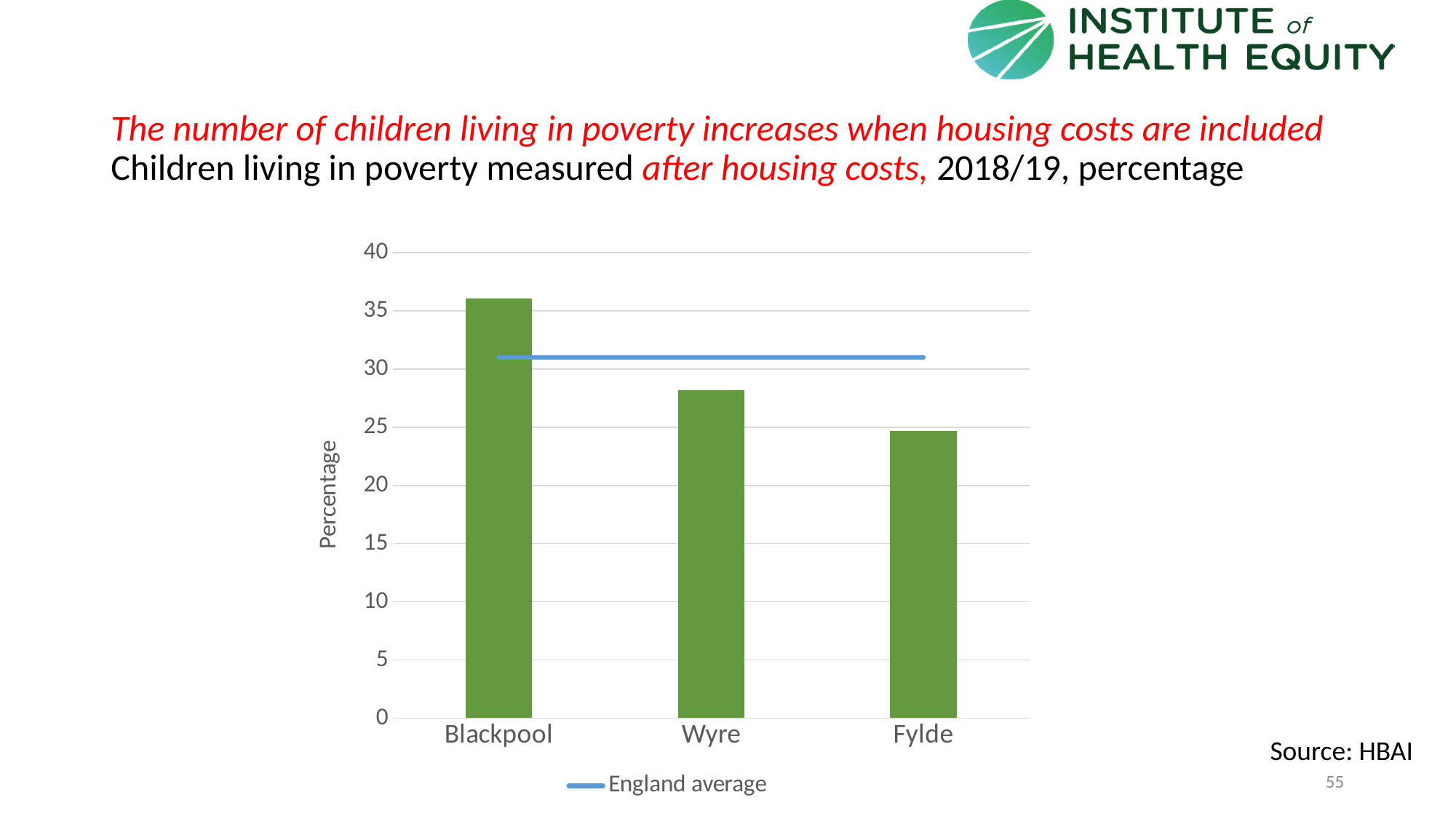
Which area's bar is above the England average line? Blackpool What kind of chart is shown on the slide? bar chart How many local areas are shown on the x axis of the chart? 3 How many entries does the chart's legend list? 1 What is the label on the vertical axis of the chart? Percentage Which area has the lowest percentage of children living in poverty after housing costs? Fylde Is the value for Blackpool greater or less than 30? greater Which area has the highest percentage of children living in poverty after housing costs? Blackpool Which has the larger value, Wyre or Fylde? Wyre Do the bar values rise or fall moving from Blackpool to Fylde along the x axis? fall Is the value for Wyre greater or less than 30? less Is the value for Fylde greater or less than 20? greater